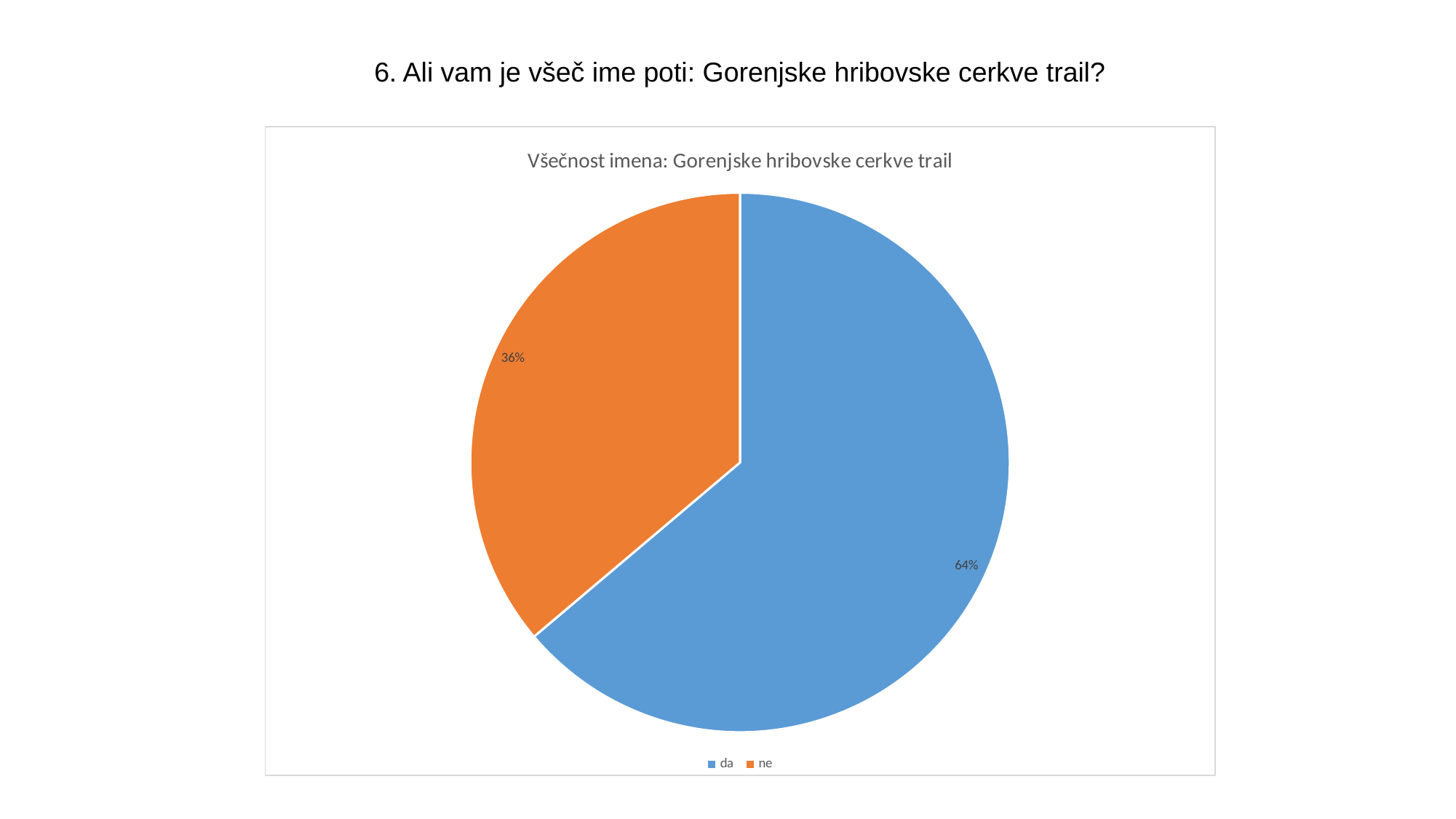
Which category has the smallest slice of the pie? ne What colour is the "ne" slice? orange How many entries does the legend list? 2 How many categories does the pie chart show? 2 What kind of chart is shown on the slide? pie chart Which category has the largest slice of the pie? da What share of the pie does the "ne" slice represent? 36% What is the difference in percentage points between the "da" and "ne" slices? 28 Which is larger, the "da" slice or the "ne" slice? da Is the share for "ne" greater or less than 50%? less What share of the pie does the "da" slice represent? 64% What is the chart's title? Všečnost imena: Gorenjske hribovske cerkve trail